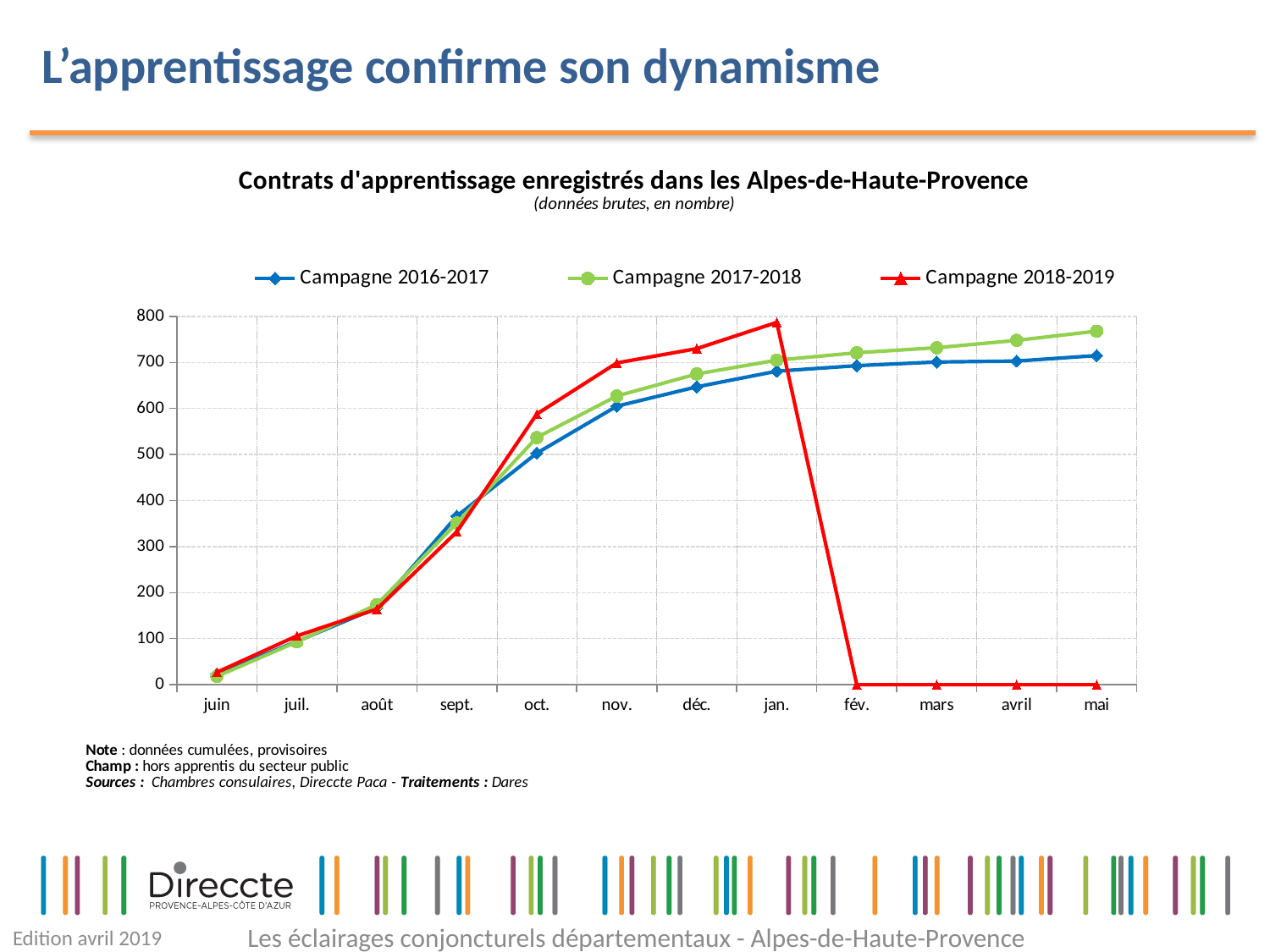
Is the value for Campagne 2018-2019 in oct. greater or less than 500? greater How many series does the legend list? 3 What kind of chart is shown on the slide? line chart Is the value for Campagne 2017-2018 in déc. greater or less than 700? less In mai, which series has the higher value, Campagne 2016-2017 or Campagne 2017-2018? Campagne 2017-2018 How many months are shown on the x axis? 12 Is the value for Campagne 2018-2019 in jan. greater or less than 700? greater In which month does Campagne 2017-2018 reach its highest value? mai In jan., which series has the higher value, Campagne 2018-2019 or Campagne 2017-2018? Campagne 2018-2019 Do the values for Campagne 2017-2018 rise or fall from juin to mai? rise